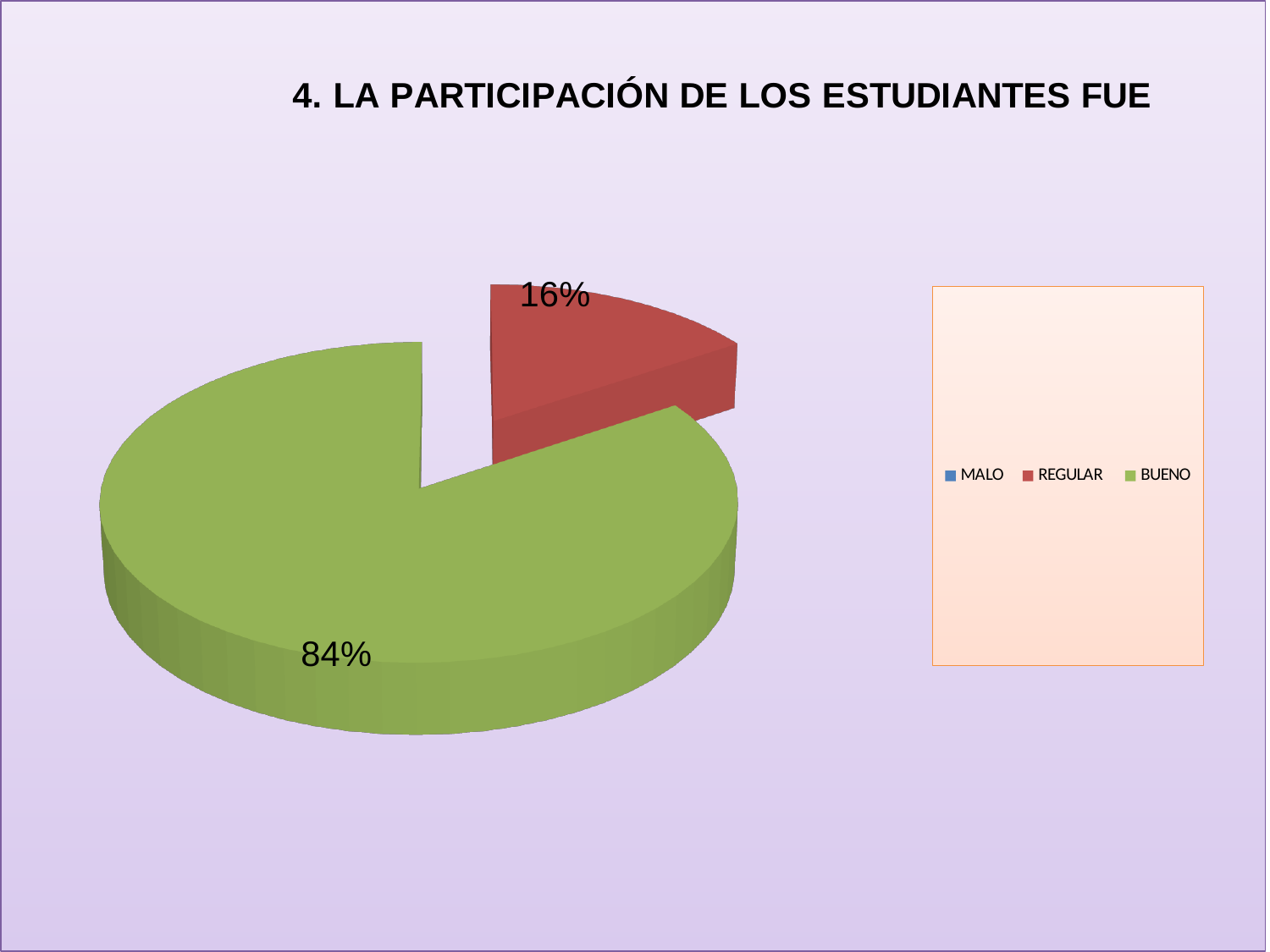
Is the share for REGULAR greater or less than 25%? less Is the share for BUENO greater or less than 50%? greater Which of the two visible slices is larger, REGULAR or BUENO? BUENO How many categories does the legend list? 3 What percentage of the pie is labelled for REGULAR? 16% What is the difference in percentage points between the BUENO and REGULAR slices? 68 What kind of chart is shown on the slide? pie chart Which category has the largest share of the pie? BUENO What percentage of the pie is labelled for BUENO? 84% What is the title of the chart? 4. LA PARTICIPACIÓN DE LOS ESTUDIANTES FUE What colour is the BUENO slice? green